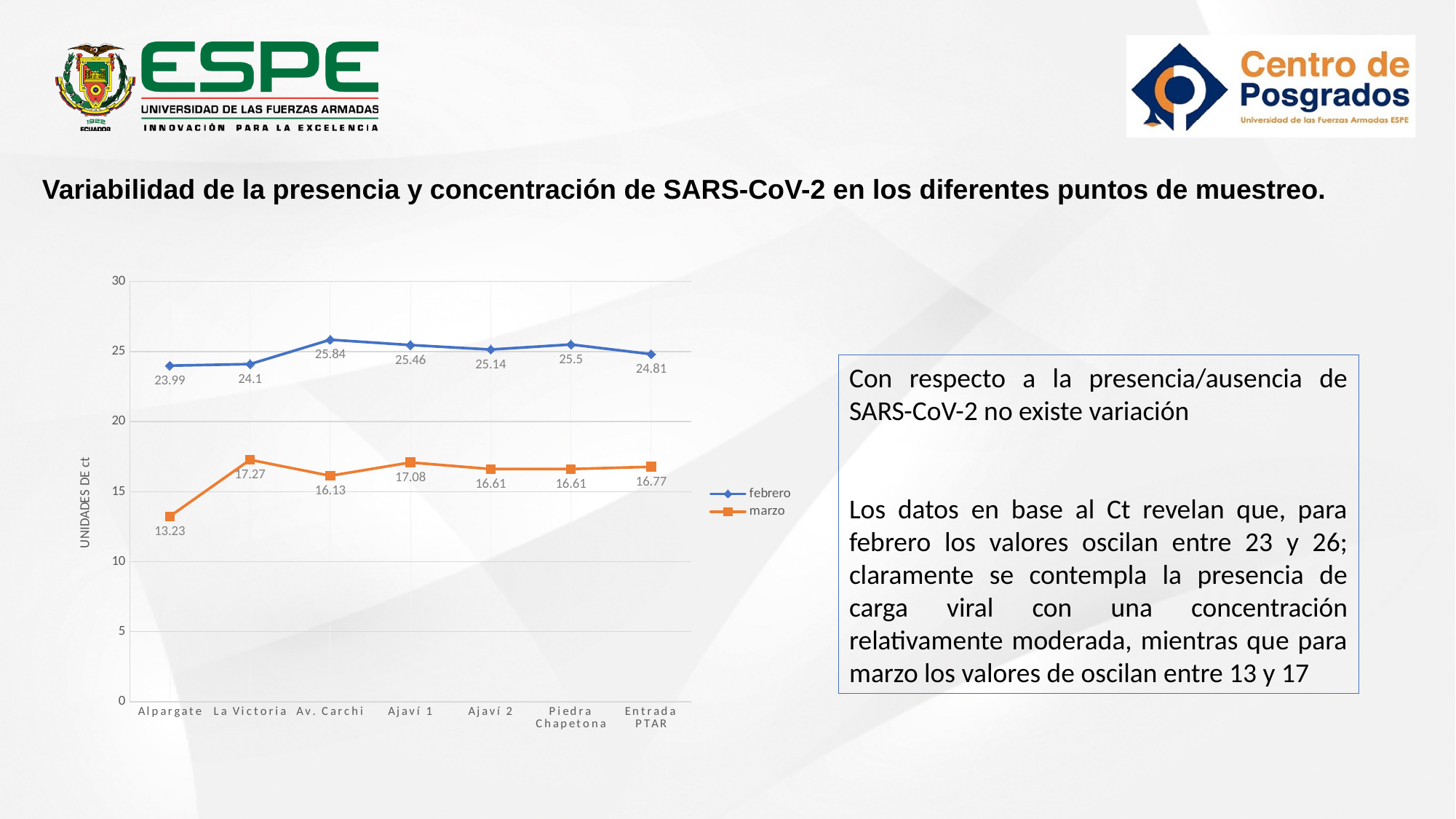
What is the febrero value for Ajaví 2? 25.14 Which is larger, the marzo value at La Victoria or at Av. Carchi? La Victoria How many series does the legend list? 2 What is the difference between the febrero and marzo values at Alpargate? 10.76 Which sampling point has the lowest marzo value? Alpargate What is the label of the y axis? UNIDADES DE ct Which sampling point has the highest febrero value? Av. Carchi How many sampling points are shown on the x axis? 7 What is the marzo value for Alpargate? 13.23 What is the marzo value for Entrada PTAR? 16.77 What is the febrero value for Av. Carchi? 25.84 What kind of chart is shown on the slide? Line chart